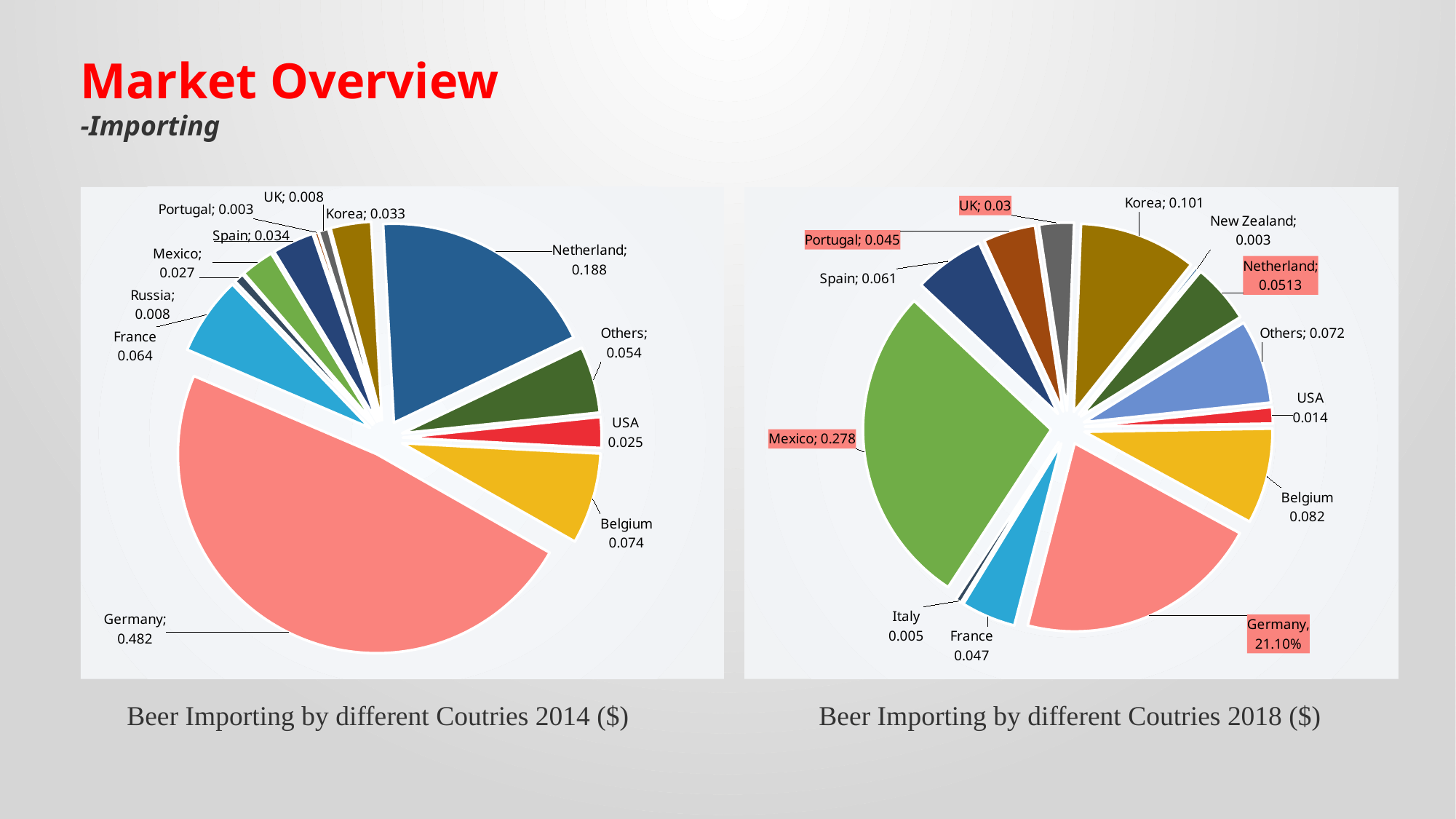
In the 2018 chart, which is larger, the value for Korea or the value for Belgium? Korea In the 2014 chart, which country has the largest slice? Germany In the 2014 chart, what is the value for Germany? 0.482 In the 2018 chart, what is the value shown for Germany? 21.10% In the 2014 chart, what is the value for Netherland? 0.188 How many categories are shown in the 2018 chart? 13 In the 2018 chart, what is the value for Mexico? 0.278 What type of chart is used for the 2014 data? Pie chart In the 2014 chart, what is the difference between the values for Belgium and France? 0.010 In the 2018 chart, which country has the largest slice? Mexico In the 2018 chart, which category has the smallest value? New Zealand In the 2014 chart, which category has the smallest value? Portugal